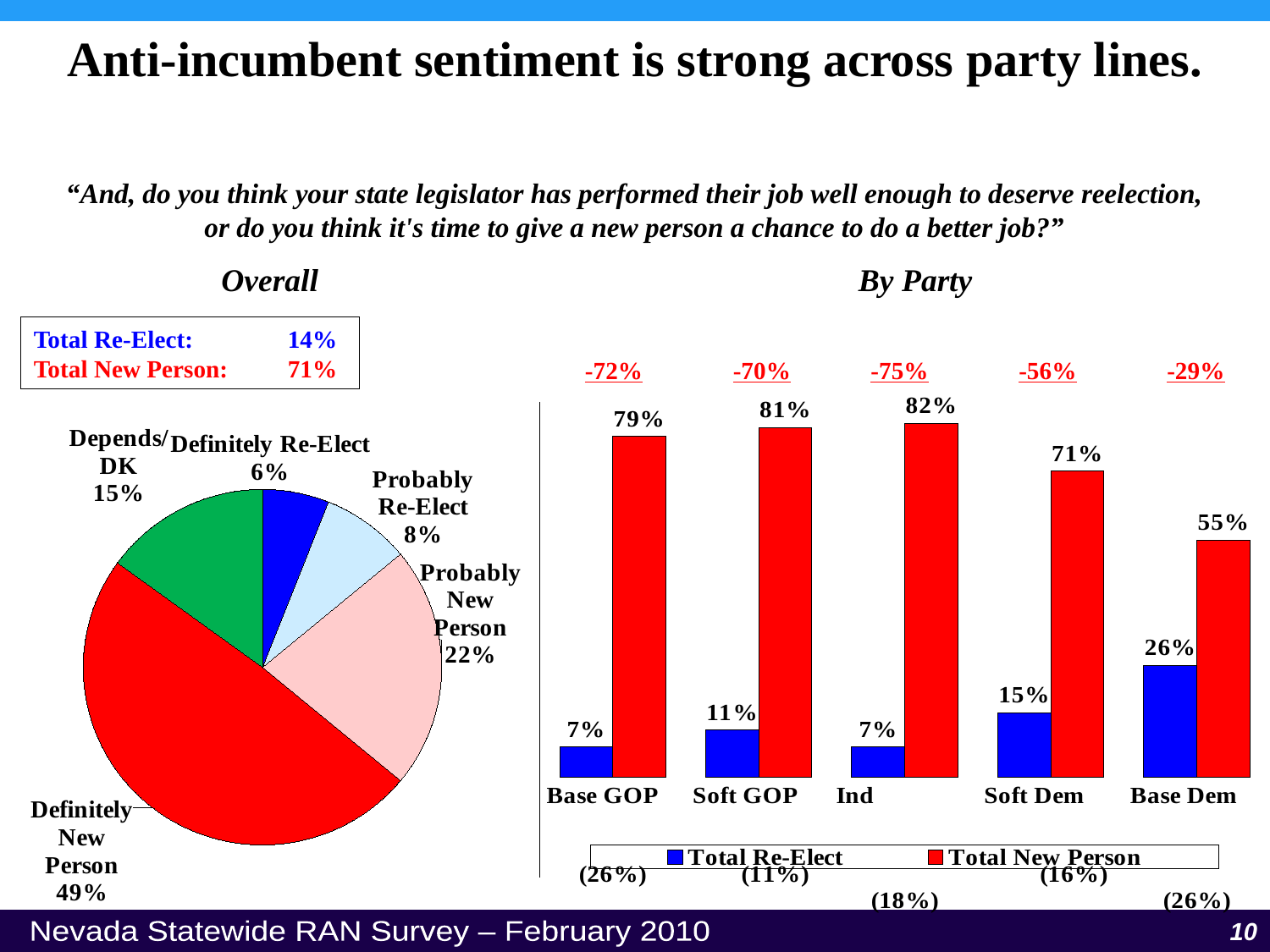
How many slices does the Overall pie chart have? 5 How many series does the legend of the By Party chart list? 2 In the Overall pie chart, which slice is the smallest? Definitely Re-Elect In the Overall pie chart, what share is Depends/DK? 15% What kind of chart is the Overall chart? Pie chart In the Overall pie chart, what share is Definitely New Person? 49% In the By Party chart, what is the Total New Person value for Ind? 82% In the By Party chart, which party group has the highest Total New Person value? Ind In the By Party chart, is the Total Re-Elect value larger for Soft GOP or Soft Dem? Soft Dem In the By Party chart, what is the difference between Total New Person and Total Re-Elect for Soft Dem? 56% In the By Party chart, which party group has the lowest Total New Person value? Base Dem In the By Party chart, what is the Total Re-Elect value for Base Dem? 26%